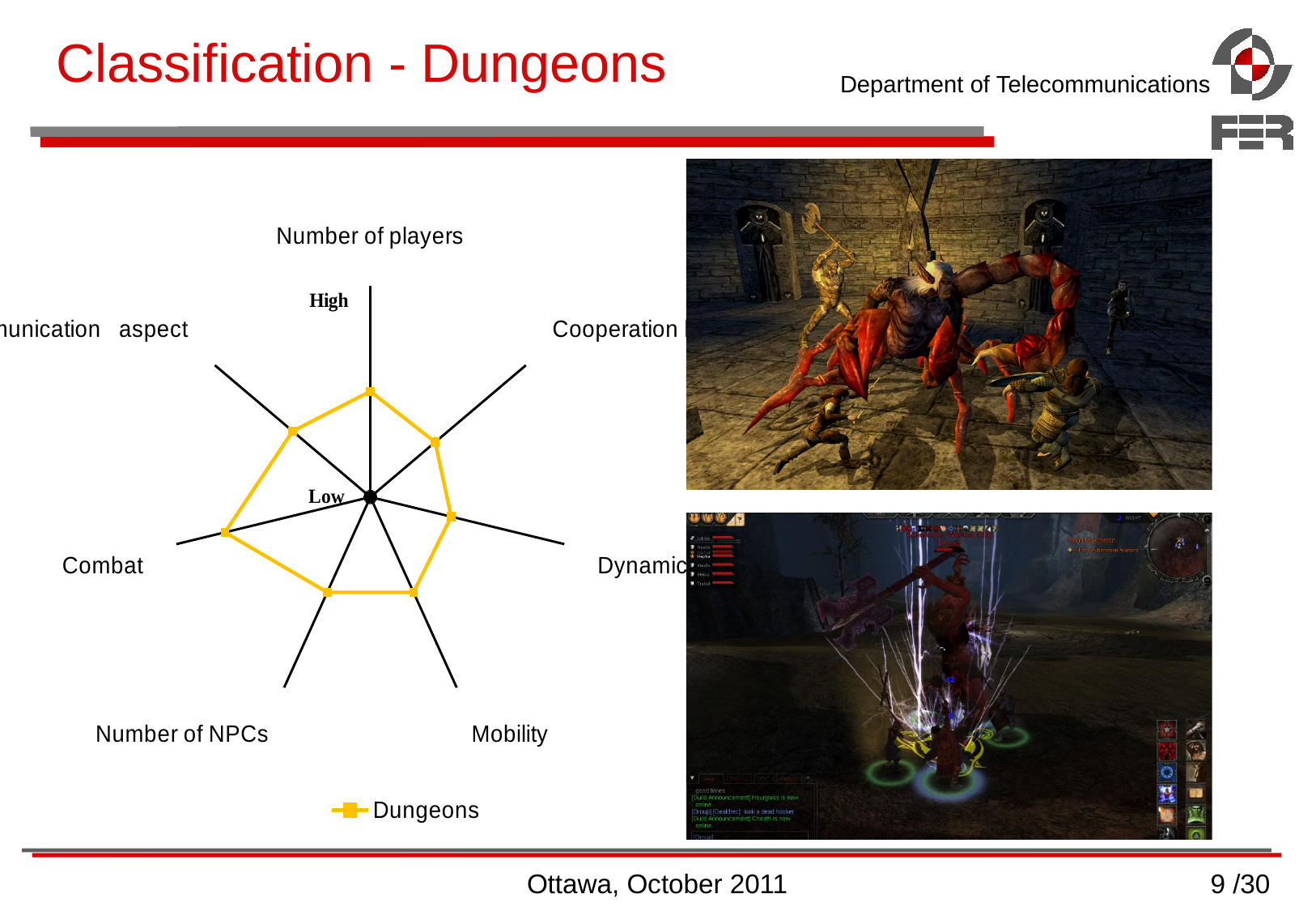
Which is larger for Dungeons, Combat or Cooperation? Combat How many series does the chart legend list? 1 Which category has the highest value for Dungeons? Combat What kind of chart is shown on the slide? Radar chart Which is larger for Dungeons, Combat or Number of NPCs? Combat What is the name of the series shown in the chart legend? Dungeons Which is larger for Dungeons, Combat or Mobility? Combat What two labels mark the ends of the scale on the radar chart's vertical axis? High and Low How many axes (categories) does the radar chart have? 7